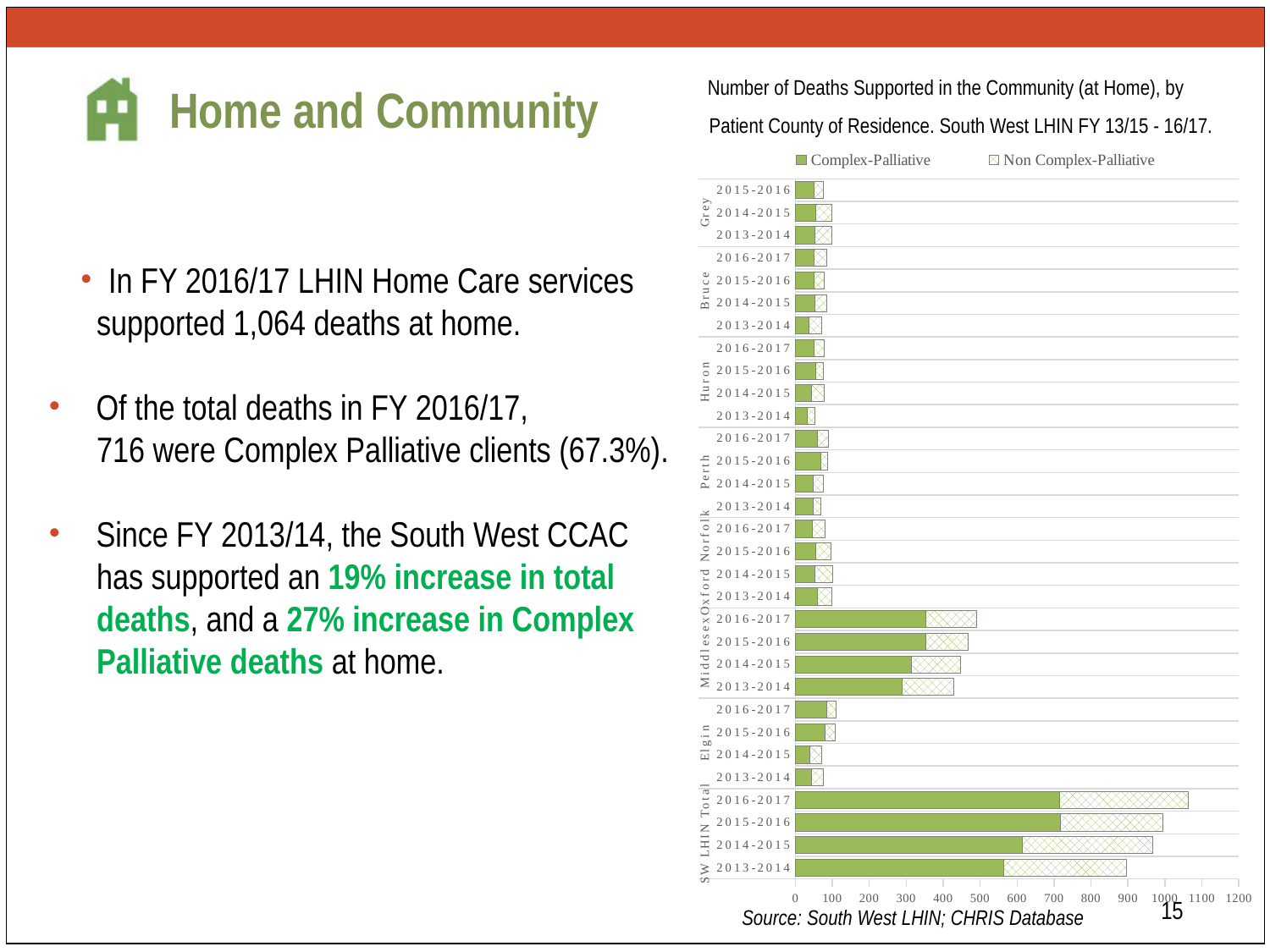
How many series does the chart legend list? 2 For SW LHIN Total, do the total bars rise or fall from 2013-2014 to 2016-2017? rise Is the total bar for Elgin 2016-2017 greater or less than 200? less Which bar in the chart is the longest overall? SW LHIN Total 2016-2017 What are the two series named in the chart legend? Complex-Palliative and Non Complex-Palliative Is the total bar for SW LHIN Total 2016-2017 greater or less than 1000? greater Which is larger, the total bar for Middlesex 2016-2017 or the total bar for Elgin 2016-2017? Middlesex 2016-2017 What kind of chart is shown on the slide? Stacked bar chart What is the title of the chart? Number of Deaths Supported in the Community (at Home), by Patient County of Residence. South West LHIN FY 13/15 - 16/17. Is the total bar for Middlesex 2016-2017 greater or less than 400? greater Among the individual counties (excluding the SW LHIN Total), which county has the longest bars? Middlesex